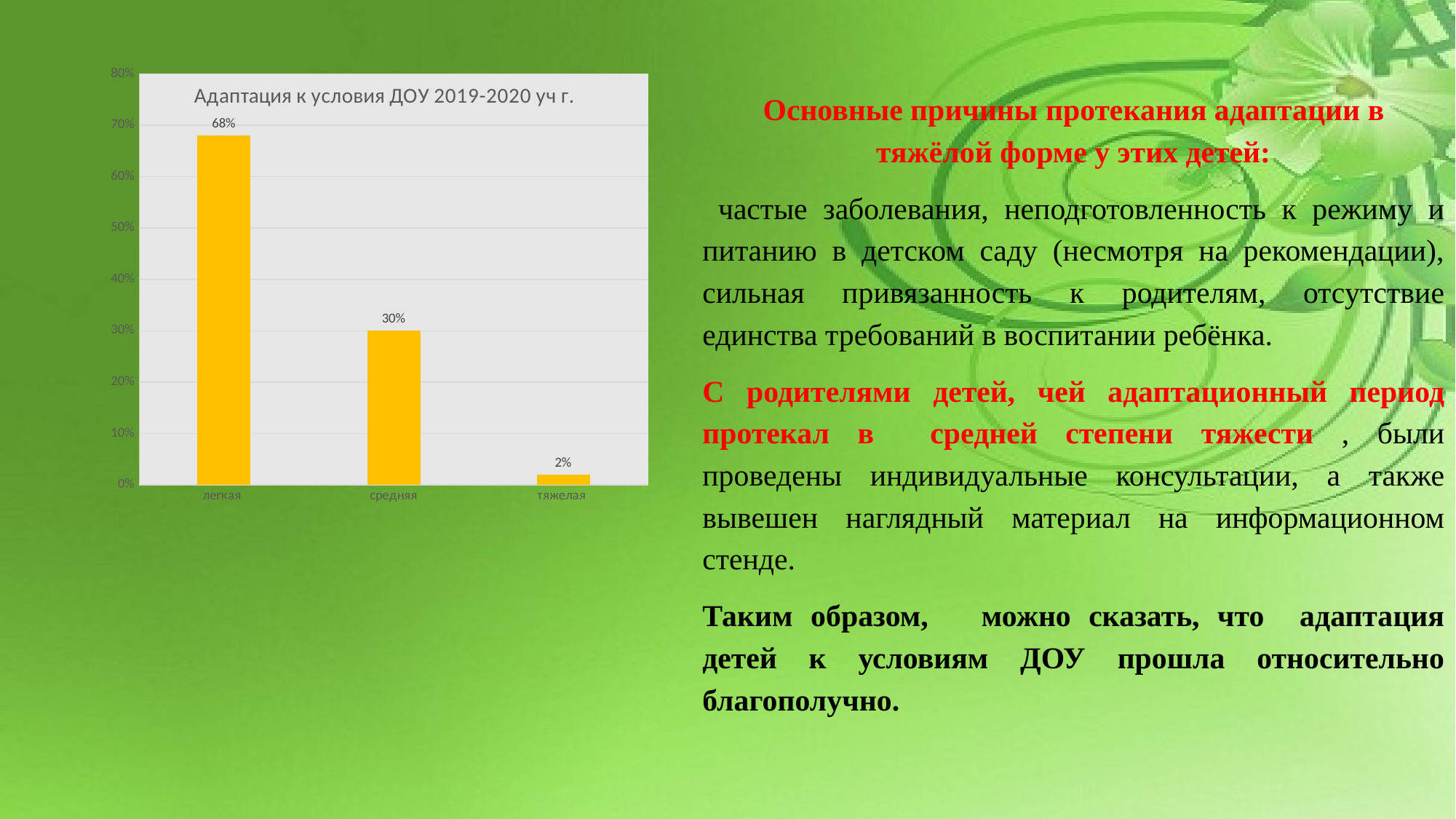
Is the value for легкая greater or less than 60%? greater What is the value for легкая? 68% Which category has the highest value? легкая What kind of chart is shown on the slide? bar chart What is the difference between the values for средняя and тяжелая? 28% How many categories are shown on the x axis? 3 Which category has the lowest value? тяжелая What is the difference between the values for легкая and средняя? 38% What is the value for тяжелая? 2% What is the value for средняя? 30% Which is larger, the value for легкая or the value for средняя? легкая What is the title of the chart? Адаптация к условия ДОУ 2019-2020 уч г.